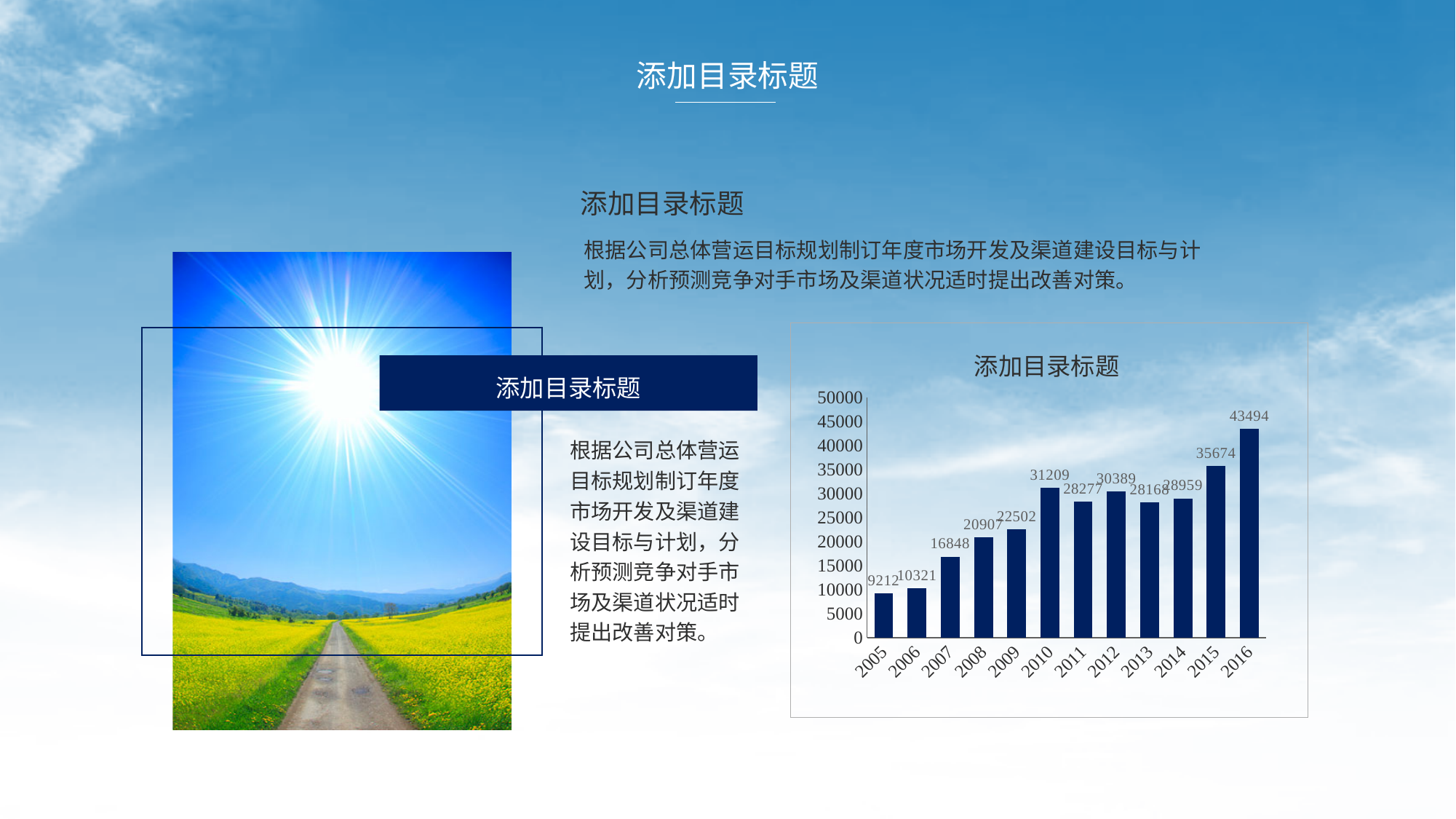
What is the value for 2005? 9212 What is the value for 2013? 28168 Is the value for 2007 greater or less than 20000? less Which year has the lowest value? 2005 Which year has the highest value? 2016 Which is larger, the value for 2010 or the value for 2011? 2010 What is the value for 2016? 43494 What type of chart is shown on the slide? bar chart What is the difference between the values for 2016 and 2015? 7820 What is the value for 2010? 31209 How many years are shown on the x axis? 12 What is the title of the chart? 添加目录标题